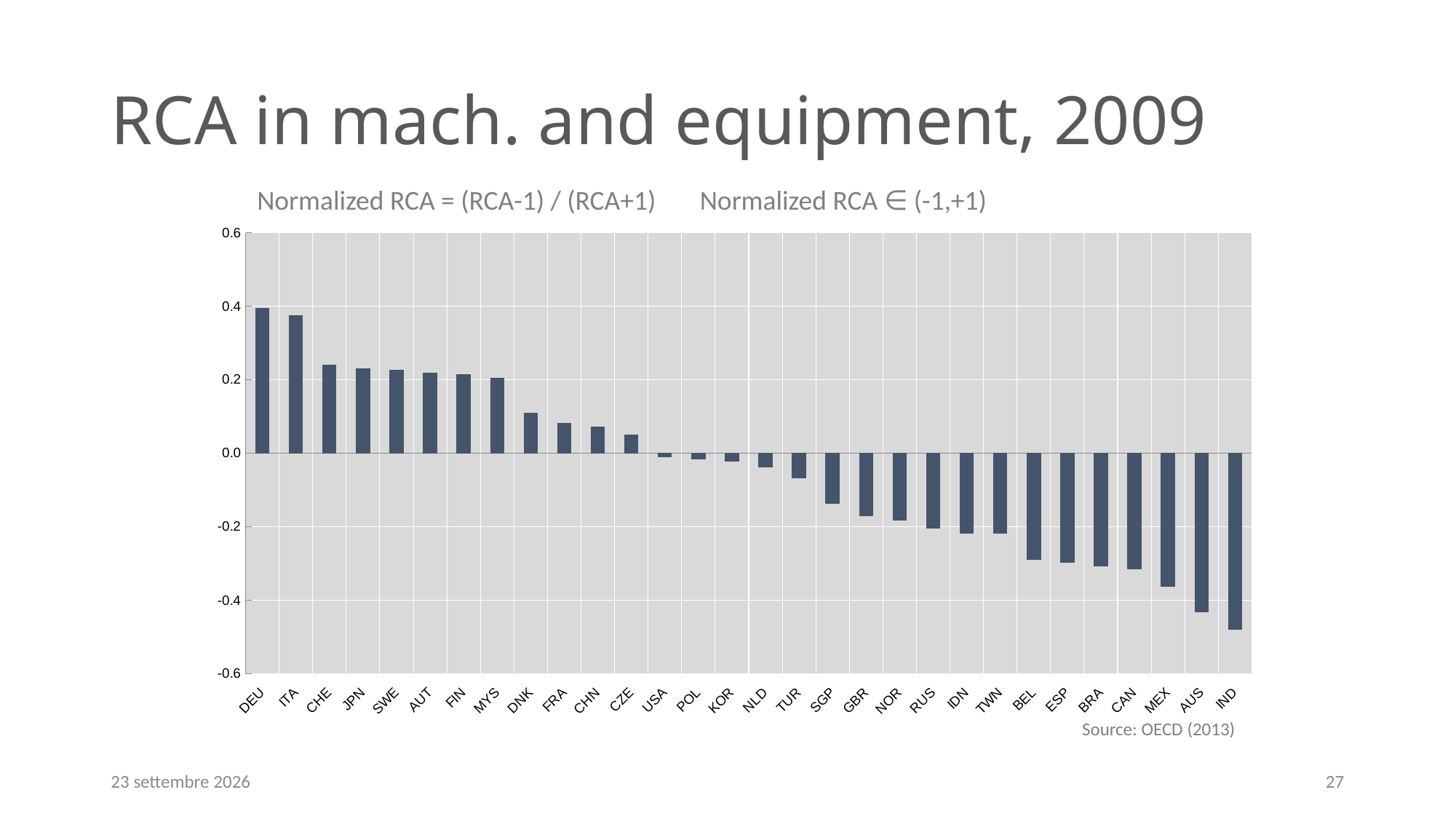
What source is cited below the chart? OECD (2013) What is the title of the slide containing the chart? RCA in mach. and equipment, 2009 Is the value for IND greater or less than -0.4? less What kind of chart is shown on the slide? bar chart Is the value for DNK greater or less than 0.2? less Which country has the highest normalized RCA in the chart? DEU Is the value for DEU greater or less than 0.2? greater How many countries are plotted on the x axis of the chart? 30 Which country has the lowest normalized RCA in the chart? IND Do the values rise or fall moving from left to right along the x axis? fall Which has the larger value, JPN or FRA? JPN